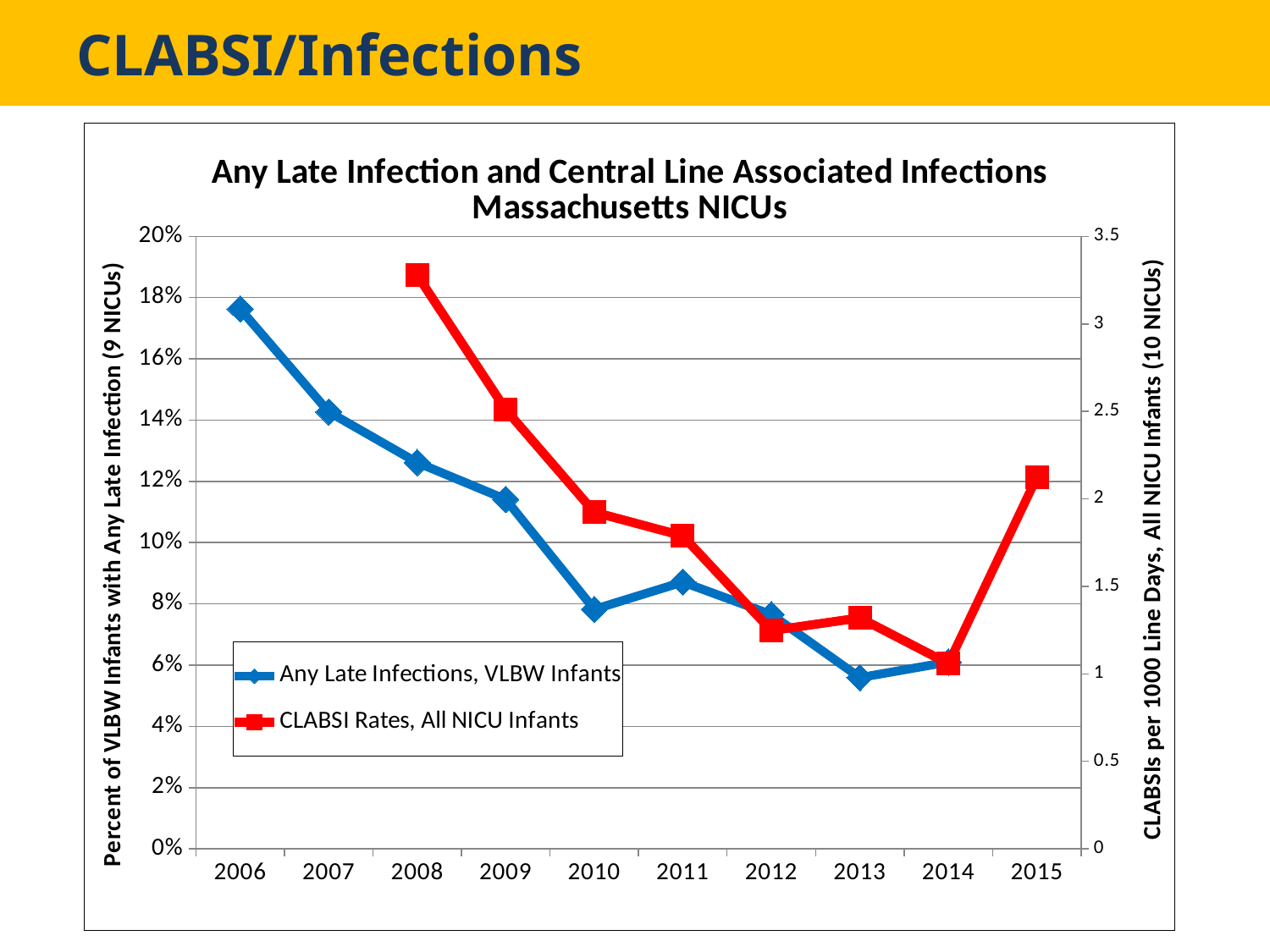
Is the value for Any Late Infections, VLBW Infants in 2006 greater or less than 16%? greater Which is larger for Any Late Infections, VLBW Infants: the value in 2007 or the value in 2009? 2007 In which year is the Any Late Infections, VLBW Infants series lowest? 2013 In which year is the CLABSI Rates, All NICU Infants series lowest? 2014 Is the value for CLABSI Rates, All NICU Infants in 2008 greater or less than 3? greater In which year is the CLABSI Rates, All NICU Infants series highest? 2008 In which year is the Any Late Infections, VLBW Infants series highest? 2006 How many series does the legend list? 2 How many years are shown on the x axis? 10 Does the Any Late Infections, VLBW Infants series rise or fall from 2006 to 2010? fall What kind of chart is shown on the slide? line chart Is the value for CLABSI Rates, All NICU Infants in 2015 greater or less than 1.5? greater